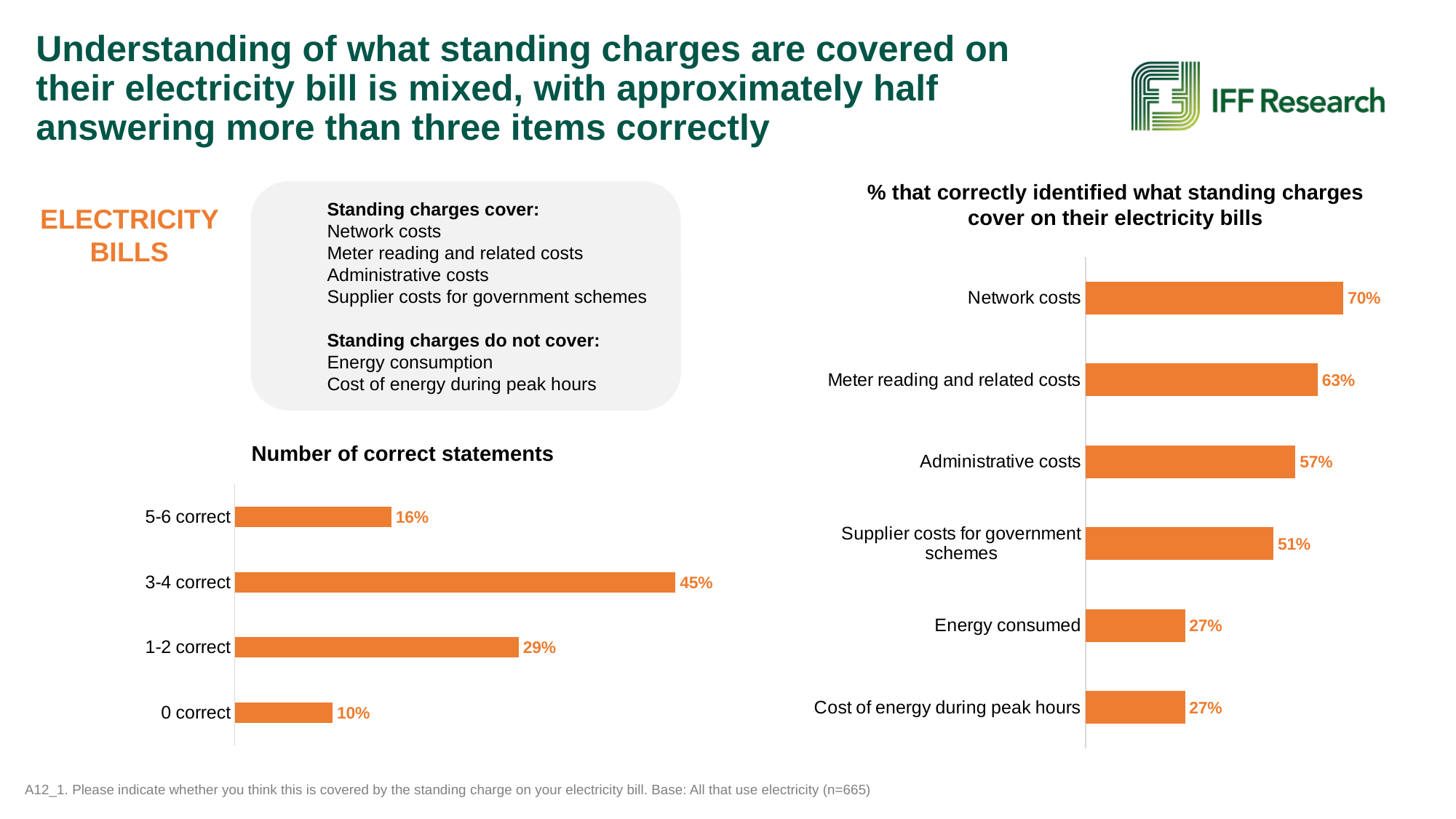
What type of chart is the '% that correctly identified what standing charges cover on their electricity bills' chart? Bar chart In the '% that correctly identified what standing charges cover on their electricity bills' chart, which item has the highest value? Network costs In the 'Number of correct statements' chart, what percentage answered 3-4 correct? 45% In the 'Number of correct statements' chart, which category has the lowest value? 0 correct In the 'Number of correct statements' chart, how many categories are shown? 4 In the '% that correctly identified what standing charges cover on their electricity bills' chart, what is the value for Network costs? 70% In the '% that correctly identified what standing charges cover on their electricity bills' chart, what is the difference between Network costs and Energy consumed? 43 percentage points In the 'Number of correct statements' chart, what percentage answered 0 correct? 10% In the 'Number of correct statements' chart, what is the difference between the 3-4 correct and 1-2 correct values? 16 percentage points In the '% that correctly identified what standing charges cover on their electricity bills' chart, which is larger: Meter reading and related costs or Administrative costs? Meter reading and related costs In the 'Number of correct statements' chart, which category has the highest value? 3-4 correct In the '% that correctly identified what standing charges cover on their electricity bills' chart, what is the value for Supplier costs for government schemes? 51%